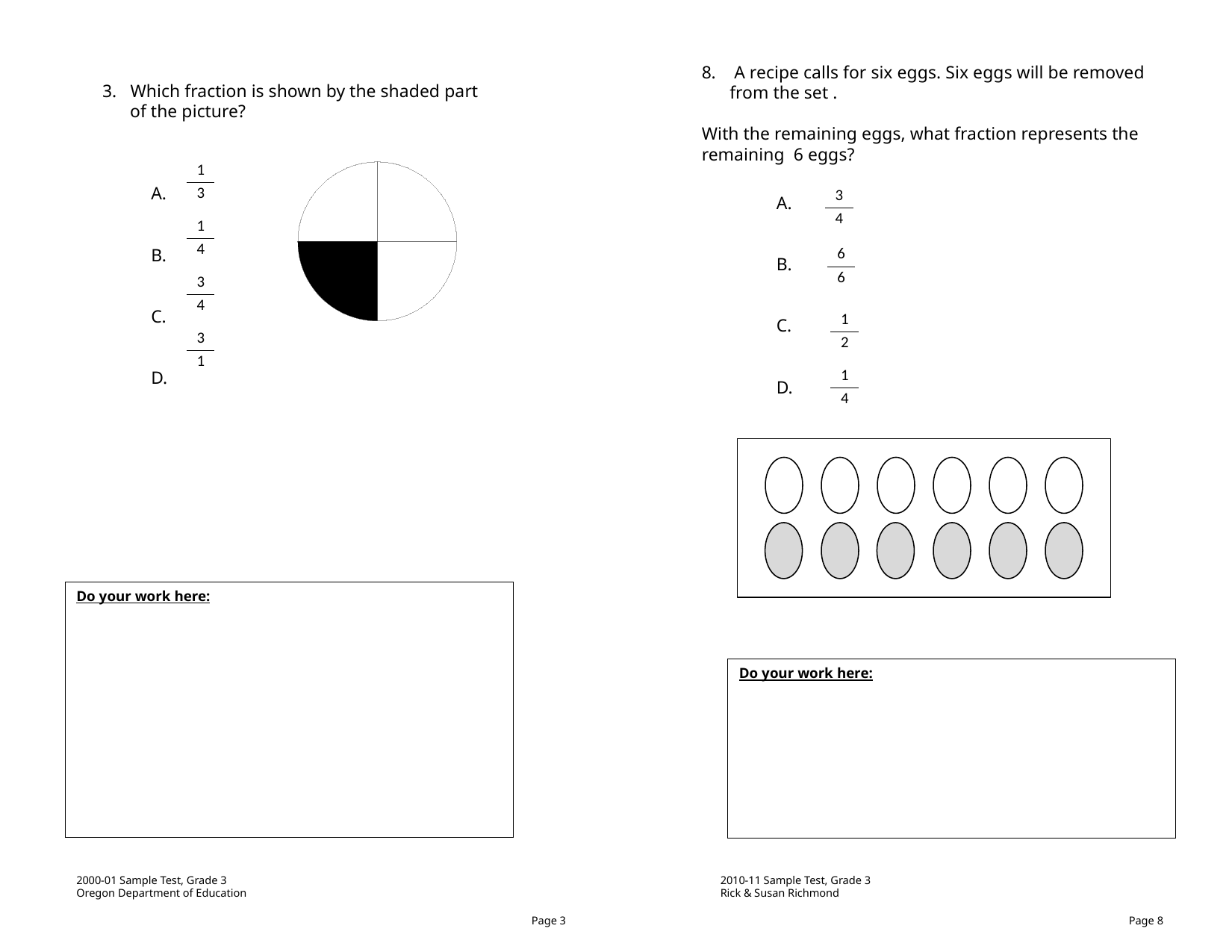
In the pie chart in question 3, is the shaded black section larger or smaller than the unshaded white part of the circle? smaller How many equal sections is the pie chart in question 3 divided into? 4 In which quadrant of the pie chart in question 3 is the shaded section located? bottom left How many eggs in total are shown in the egg picture for question 8 on the right side of the slide? 12 What kind of chart is the circle diagram in question 3 on the left side of the slide? pie chart How many sections of the pie chart in question 3 are shaded black? 1